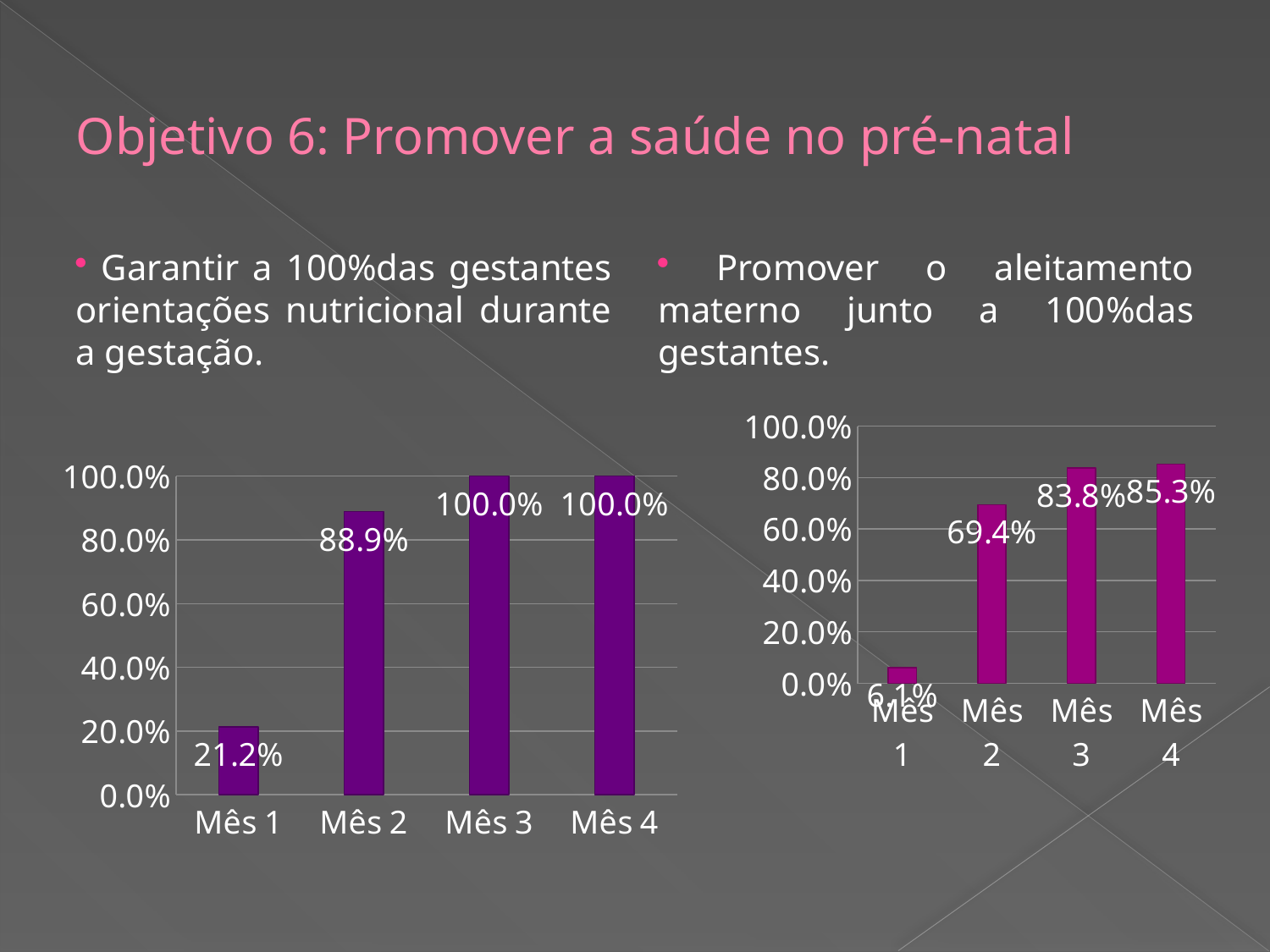
What kind of chart is the right chart? Bar chart In the right chart, what is the difference between the values for Mês 4 and Mês 3? 1.5% In the right chart, which is larger, the value for Mês 2 or the value for Mês 3? Mês 3 In the left chart, what is the value for Mês 1? 21.2% How many categories does the left chart show? 4 In the left chart, which month has the lowest value? Mês 1 In the right chart, which month has the highest value? Mês 4 In the right chart, what is the value for Mês 1? 6.1% In the right chart, what is the value for Mês 3? 83.8% In the left chart, what is the value for Mês 2? 88.9% In the right chart, which month has the lowest value? Mês 1 In the left chart, what is the difference between the values for Mês 2 and Mês 1? 67.7%